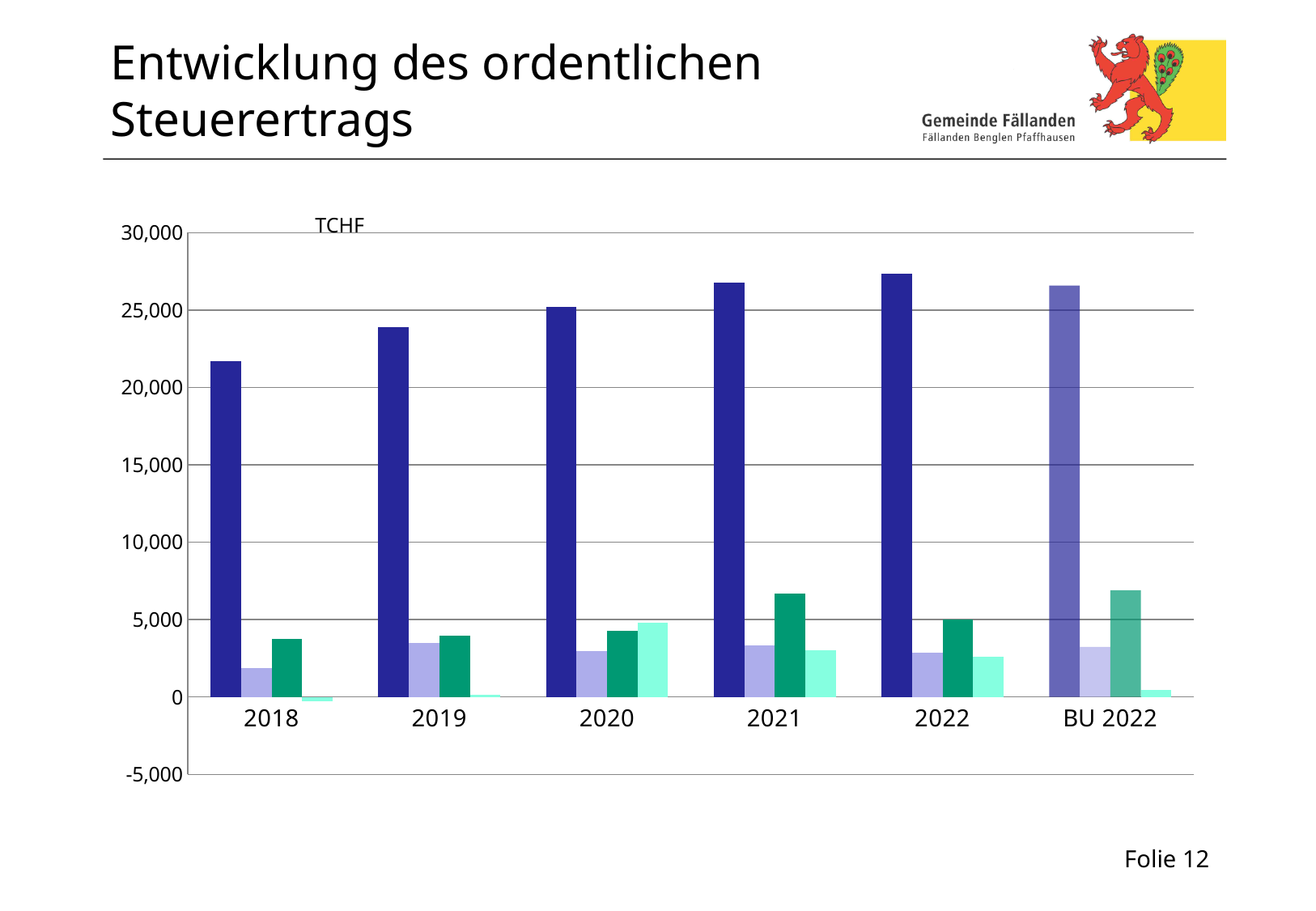
How many bars are plotted for each year on the chart? 4 What is the title of the slide containing the chart? Entwicklung des ordentlichen Steuerertrags Is the value of the dark blue bar for 2021 greater or less than 25,000? greater Is the value of the dark blue bar for 2019 greater or less than 25,000? less Which year has the lowest dark blue bar? 2018 Is the value of the green bar for 2021 greater or less than 5,000? greater Do the dark blue bars rise or fall from 2018 to 2022? rise Which is larger, the light cyan bar for 2020 or the light cyan bar for 2021? 2020 What unit label is shown at the top of the y axis? TCHF How many categories are shown on the x axis of the chart? 6 What kind of chart is shown on the slide? bar chart